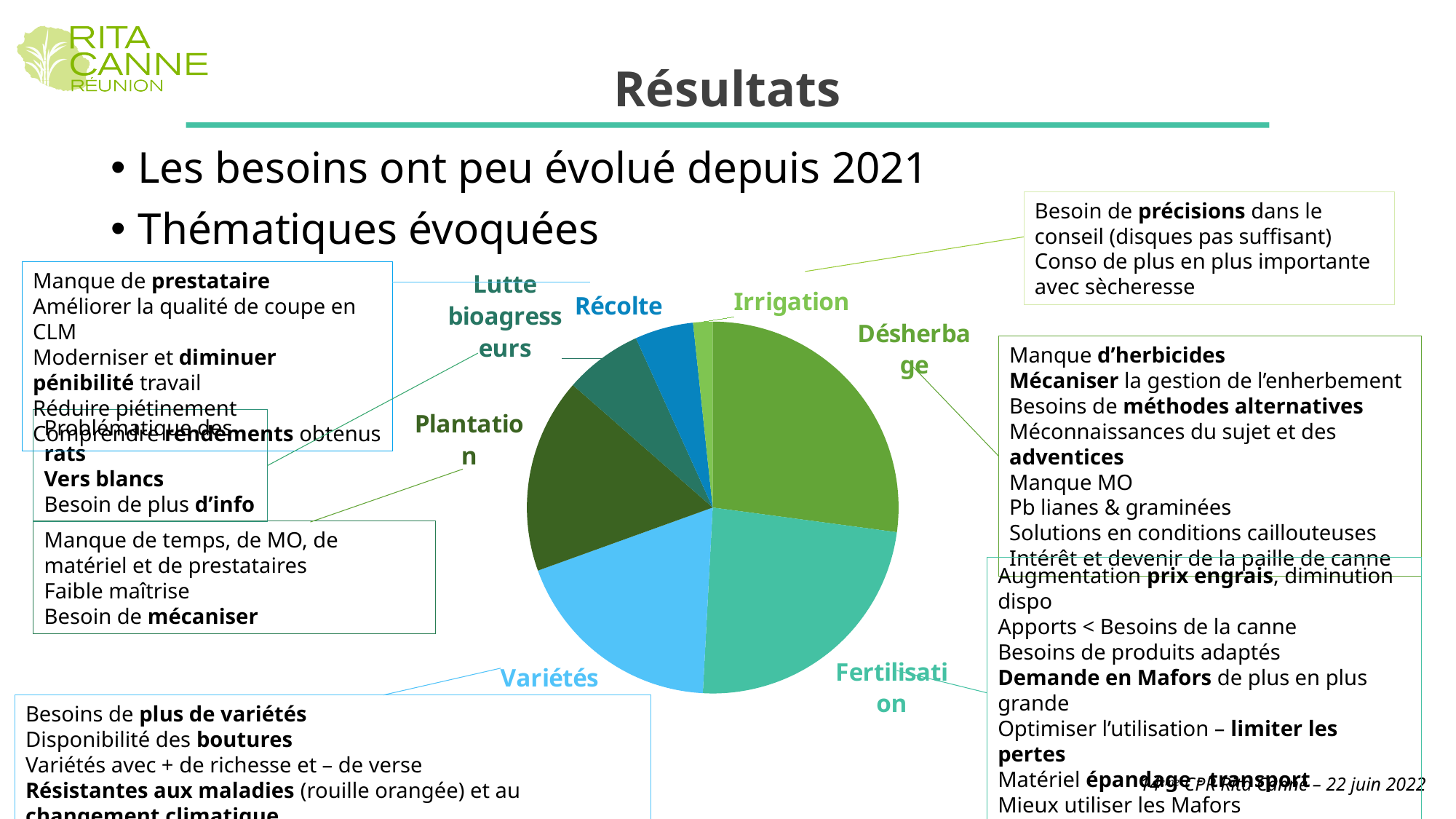
Which slice is larger, Lutte bioagresseurs or Irrigation? Lutte bioagresseurs Which slice is larger, Fertilisation or Lutte bioagresseurs? Fertilisation Which slice is larger, Plantation or Récolte? Plantation What kind of chart is shown on the slide? pie chart How many slices does the pie chart have? 7 Which category has the largest slice of the pie chart? Désherbage Which category label on the pie chart is written in light blue? Variétés Which category has the smallest slice of the pie chart? Irrigation What colour is the Désherbage slice of the pie chart? green